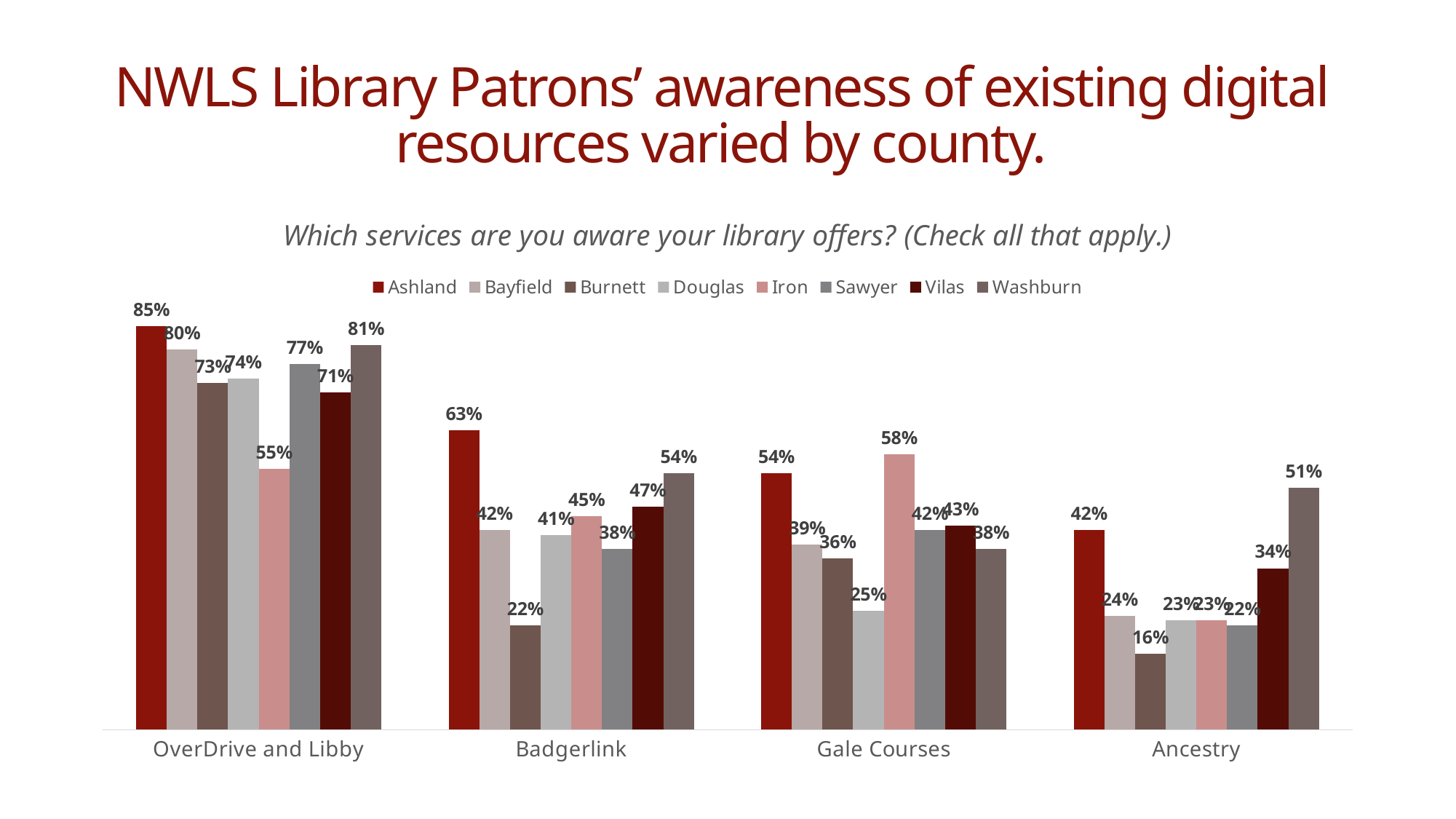
Which county has the highest awareness of Badgerlink? Ashland How many service categories are shown on the x axis? 4 What is the value for Burnett in the Badgerlink category? 22% For Gale Courses, which is larger: the value for Ashland or the value for Iron? Iron What survey question is shown as the chart's subtitle? Which services are you aware your library offers? (Check all that apply.) What is the difference between Ashland's and Iron's values for OverDrive and Libby? 30% Which county has the lowest awareness of Ancestry? Burnett What is the value for Iron in the Gale Courses category? 58% How many counties does the legend list? 8 What percentage of Ashland patrons were aware of OverDrive and Libby? 85% What type of chart is shown on the slide? Bar chart What is the value for Washburn in the Ancestry category? 51%